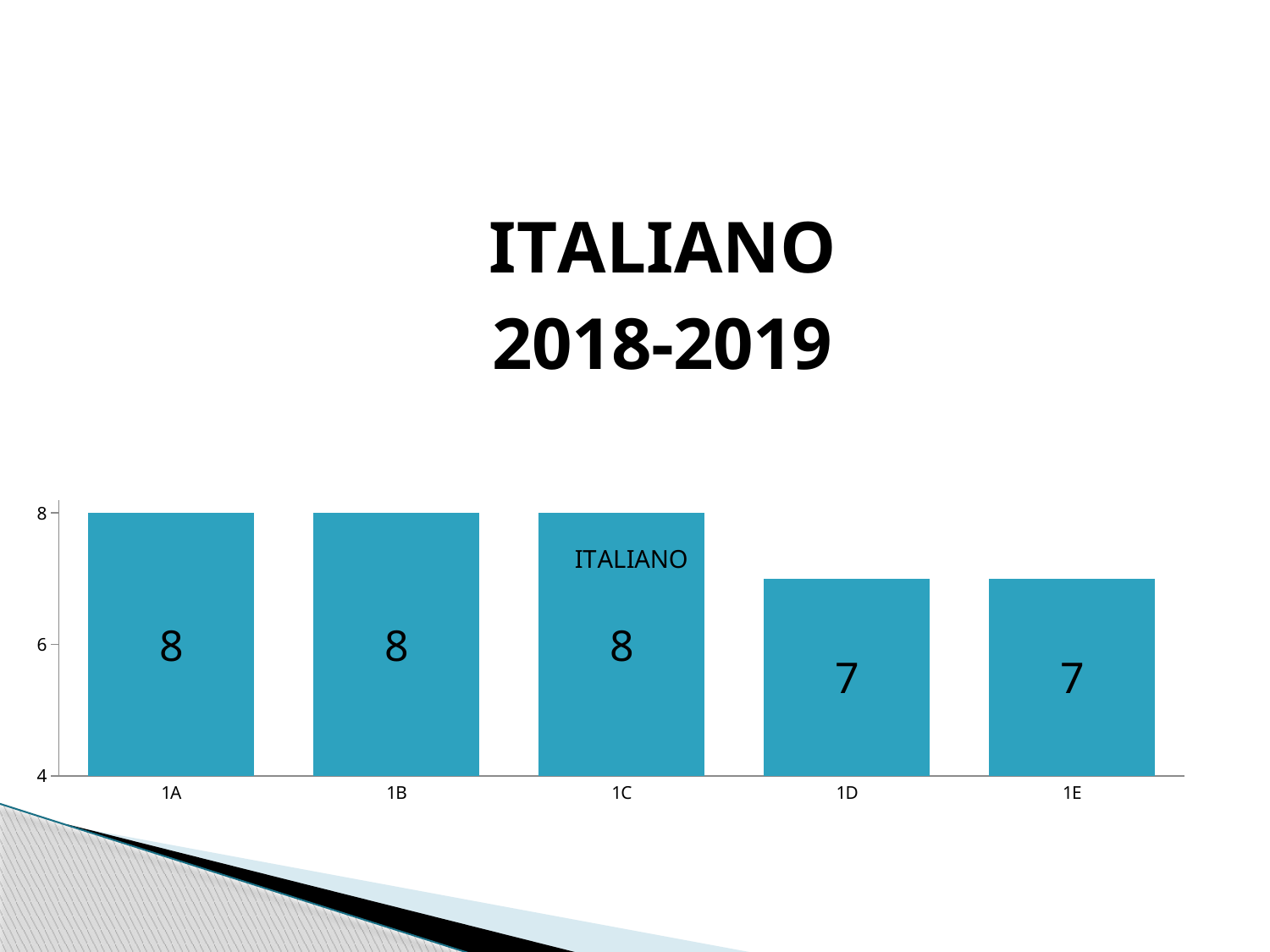
Is the value for 1B larger than the value for 1E? Yes What is the title of the slide? ITALIANO 2018-2019 What is the difference between the values for 1A and 1D? 1 Which category has the lowest value, 1B or 1D? 1D Do the values rise or fall from 1C to 1D? Fall What is the value for 1C? 8 What kind of chart is shown on the slide? Bar chart What series name is printed inside the 1C bar? ITALIANO What is the value for 1A? 8 What is the value for 1D? 7 How many categories are shown on the x axis? 5 What is the value for 1E? 7